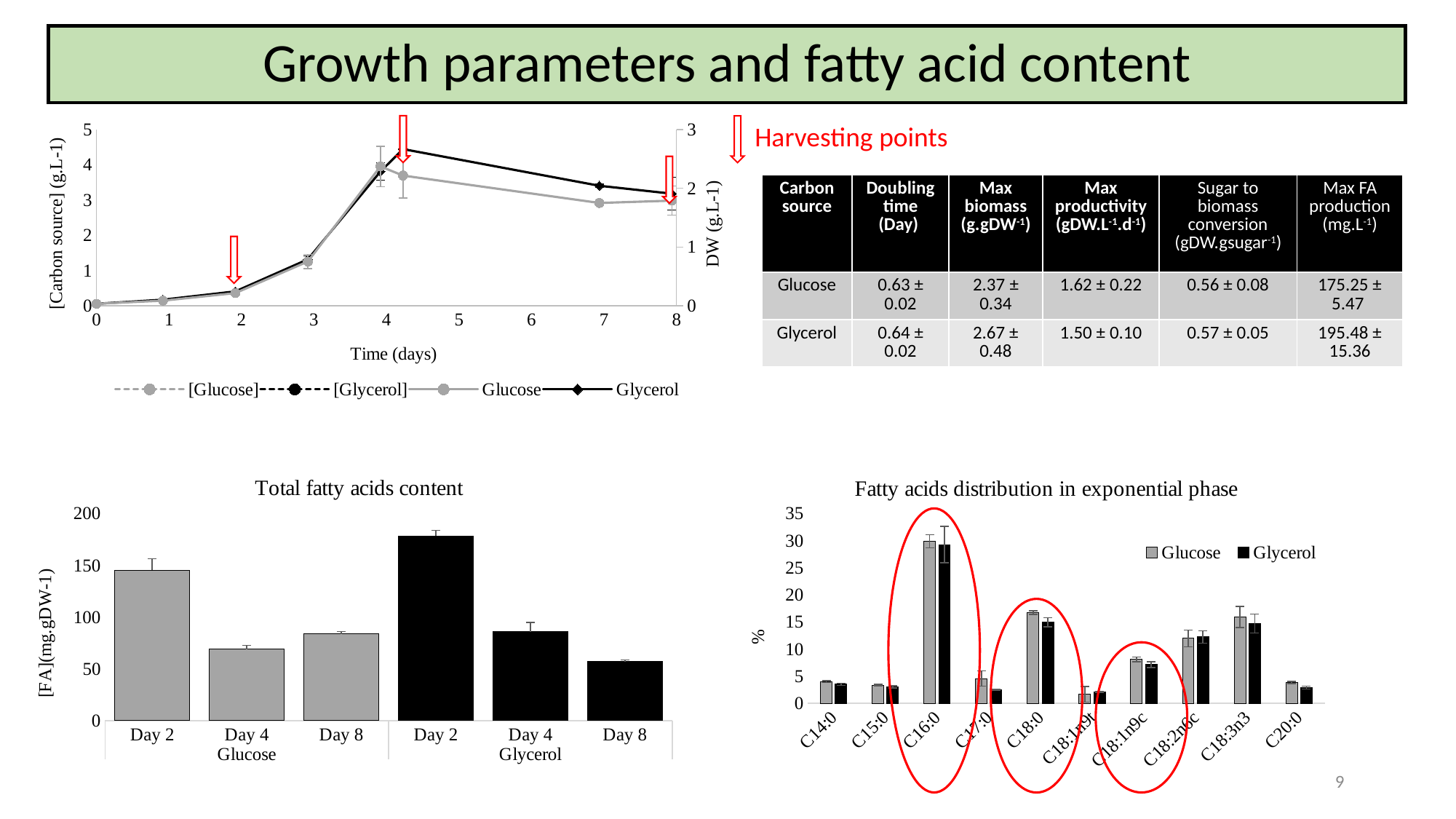
How many series does the legend of the top-left line chart list? 4 How many series does the legend of the 'Fatty acids distribution in exponential phase' chart list? 2 In the 'Total fatty acids content' chart, which bar is the lowest? Day 8 Glycerol What kind of chart is the 'Total fatty acids content' chart? bar chart In the 'Total fatty acids content' chart, which bar is the highest? Day 2 Glycerol In the 'Total fatty acids content' chart, is the value for Day 2 Glucose greater or less than 100? greater How many bars are shown in the 'Total fatty acids content' chart? 6 In the 'Fatty acids distribution in exponential phase' chart, is the Glucose value for C16:0 greater or less than 25? greater In the 'Total fatty acids content' chart, is the value for Day 4 Glucose greater or less than 100? less In the 'Total fatty acids content' chart, which is larger: Day 8 Glucose or Day 8 Glycerol? Day 8 Glucose In the 'Fatty acids distribution in exponential phase' chart, which fatty acid has the highest values? C16:0